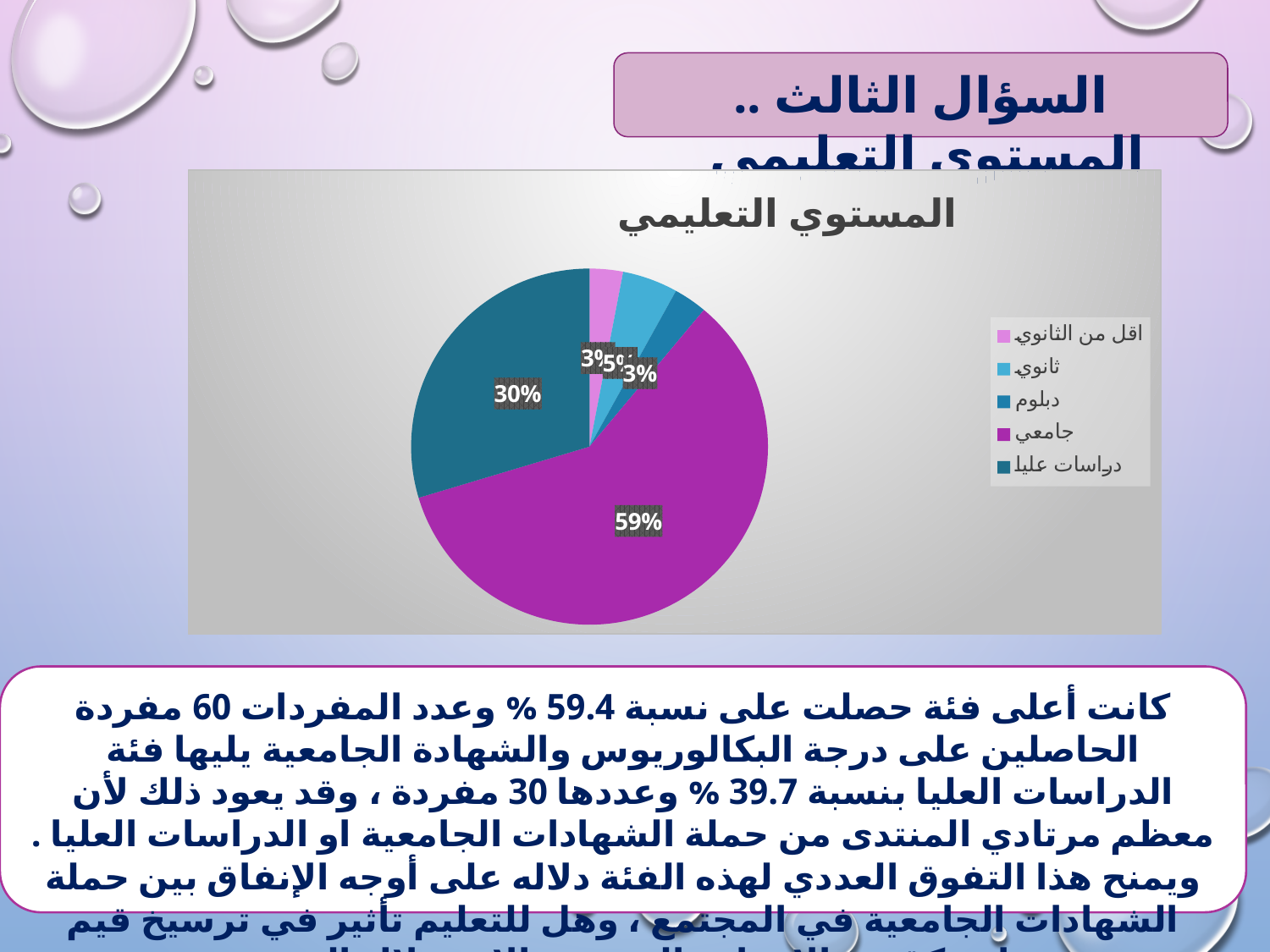
Which is larger, the ثانوي slice or the دبلوم slice? ثانوي What share of the pie does the دراسات عليا slice represent? 30% What share of the pie does the ثانوي slice represent? 5% How many categories does the legend of the pie chart list? 5 Which is larger, the جامعي slice or the دراسات عليا slice? جامعي Which category has the largest slice of the pie? جامعي What is the difference in percentage points between the ثانوي slice and the اقل من الثانوي slice? 2 What share of the pie does the جامعي slice represent? 59% What is the difference in percentage points between the جامعي slice and the دراسات عليا slice? 29 Which colour is used for the جامعي slice in the pie chart? magenta/purple What type of chart is shown on the slide? pie chart What is the title of the chart? المستوي التعليمي